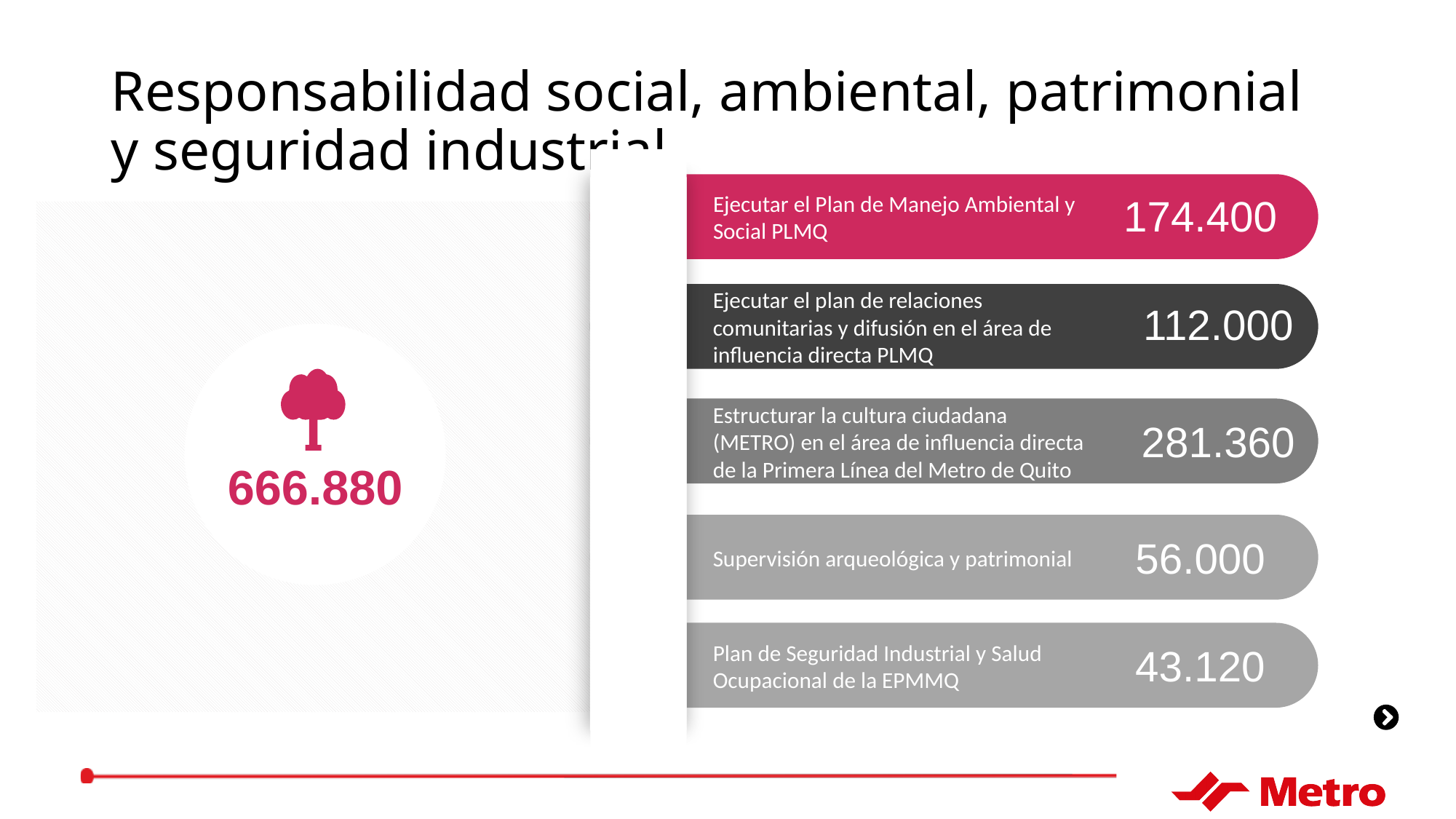
What is the difference between the value for "Supervisión arqueológica y patrimonial" and the value for "Plan de Seguridad Industrial y Salud Ocupacional de la EPMMQ"? 12.880 What is the value shown for "Ejecutar el plan de relaciones comunitarias y difusión en el área de influencia directa PLMQ"? 112.000 Which item has the lowest value? Plan de Seguridad Industrial y Salud Ocupacional de la EPMMQ What is the difference between the value for "Estructurar la cultura ciudadana (METRO)..." and the value for "Ejecutar el Plan de Manejo Ambiental y Social PLMQ"? 106.960 What is the value shown for "Plan de Seguridad Industrial y Salud Ocupacional de la EPMMQ"? 43.120 How many items are listed with values on the right side of the slide? 5 Which item has the highest value? Estructurar la cultura ciudadana (METRO) en el área de influencia directa de la Primera Línea del Metro de Quito Which is larger: the value for "Ejecutar el Plan de Manejo Ambiental y Social PLMQ" or the value for "Ejecutar el plan de relaciones comunitarias y difusión..."? Ejecutar el Plan de Manejo Ambiental y Social PLMQ What is the value shown for "Ejecutar el Plan de Manejo Ambiental y Social PLMQ"? 174.400 What is the total of the five values listed, as shown in the circle on the left? 666.880 What is the title of the slide? Responsabilidad social, ambiental, patrimonial y seguridad industrial What is the value shown for "Supervisión arqueológica y patrimonial"? 56.000